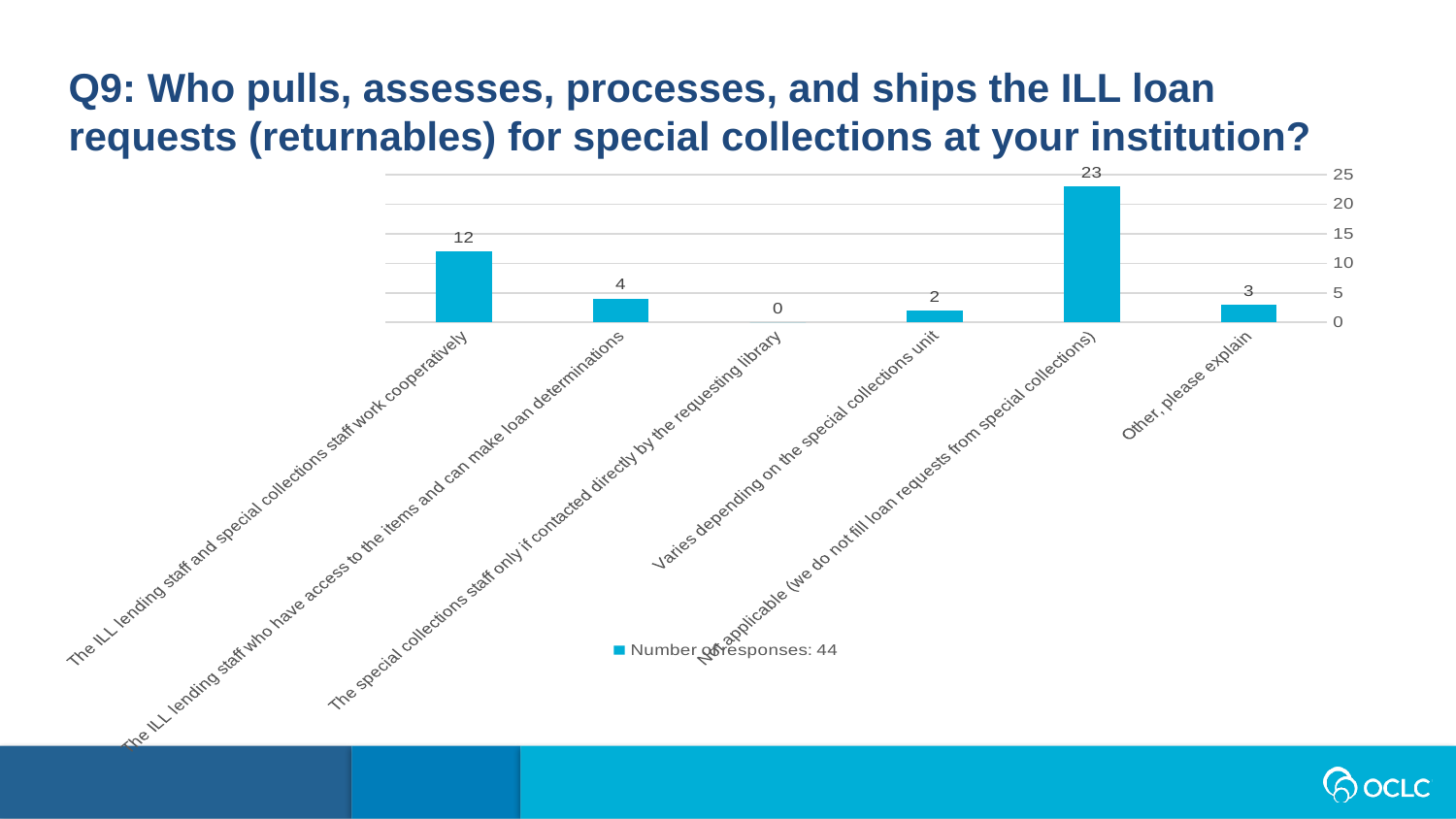
What is the difference between the values for 'Not applicable' and 'The ILL lending staff and special collections staff work cooperatively'? 11 What does the legend entry say? Number of responses: 44 Which category has the highest number of responses? Not applicable (we do not fill loan requests from special collections) What kind of chart is shown on the slide? Bar chart How many categories are shown on the x axis? 6 What is the value for 'Not applicable (we do not fill loan requests from special collections)'? 23 Which category has the lowest number of responses? The special collections staff only if contacted directly by the requesting library How many responses are there for 'The ILL lending staff and special collections staff work cooperatively'? 12 What is the value for 'Other, please explain'? 3 Which has more responses: 'The ILL lending staff who have access to the items and can make loan determinations' or 'Other, please explain'? The ILL lending staff who have access to the items and can make loan determinations What is the value for 'Varies depending on the special collections unit'? 2 Is the value for 'Not applicable (we do not fill loan requests from special collections)' greater or less than 20? greater